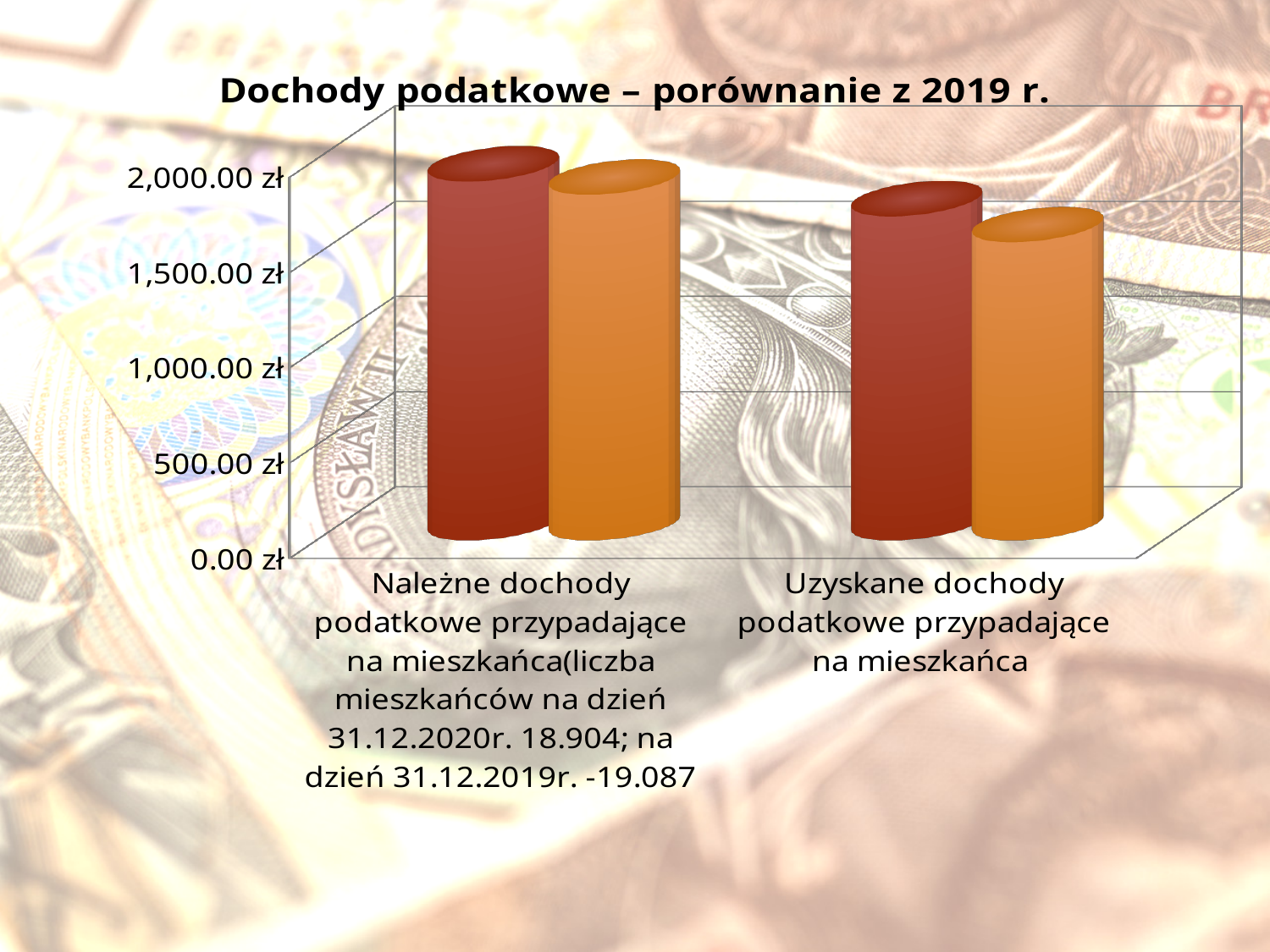
What is the title of the chart? Dochody podatkowe – porównanie z 2019 r. What is the highest value labelled on the vertical axis of the chart? 2,000.00 zł Which category has the shortest bar in the chart? Uzyskane dochody podatkowe przypadające na mieszkańca How many categories are shown on the x axis of the chart? 2 Which category has the tallest bar in the chart? Należne dochody podatkowe przypadające na mieszkańca How many bars are plotted for each category in the chart? 2 Which is larger: the dark red bar for 'Należne dochody podatkowe przypadające na mieszkańca' or the dark red bar for 'Uzyskane dochody podatkowe przypadające na mieszkańca'? Należne dochody podatkowe przypadające na mieszkańca What kind of chart is shown on the slide? bar chart Is the orange bar for 'Uzyskane dochody podatkowe przypadające na mieszkańca' greater or less than 1,000.00 zł? greater Do the bar values rise or fall from the first category to the second category along the x axis? fall Is the dark red bar for 'Należne dochody podatkowe przypadające na mieszkańca' greater or less than 1,500.00 zł? greater Is the dark red bar for 'Uzyskane dochody podatkowe przypadające na mieszkańca' greater or less than 500.00 zł? greater